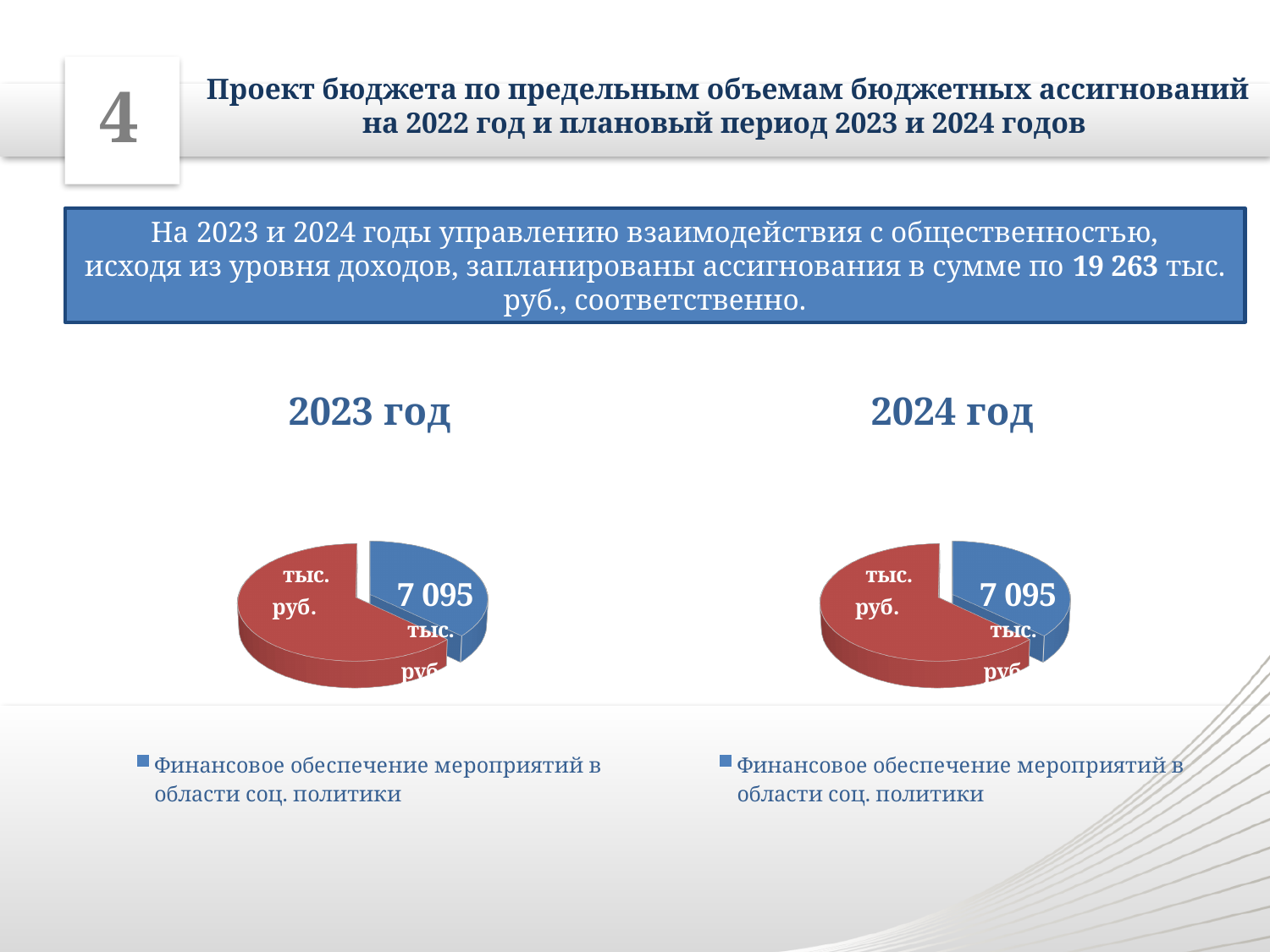
How many slices does the "2024 год" pie chart have? 2 In the "2023 год" pie chart, which slice is larger, the blue one or the red one? the red one In the "2024 год" pie chart, which slice is larger, the blue one or the red one? the red one In the "2023 год" pie chart, what value is printed on the blue slice? 7 095 тыс. руб. What is the legend entry shown below the "2024 год" pie chart? Финансовое обеспечение мероприятий в области соц. политики How many entries does the legend below the "2023 год" pie chart list? 1 What kind of chart is shown under the heading "2023 год"? pie chart What kind of chart is shown under the heading "2024 год"? pie chart In the "2023 год" pie chart, what colour is the slice labelled "7 095 тыс. руб."? blue How many slices does the "2023 год" pie chart have? 2 Is the value of the blue slice in the "2024 год" pie chart the same as the value of the blue slice in the "2023 год" pie chart? yes In the "2024 год" pie chart, what value is printed on the blue slice? 7 095 тыс. руб.